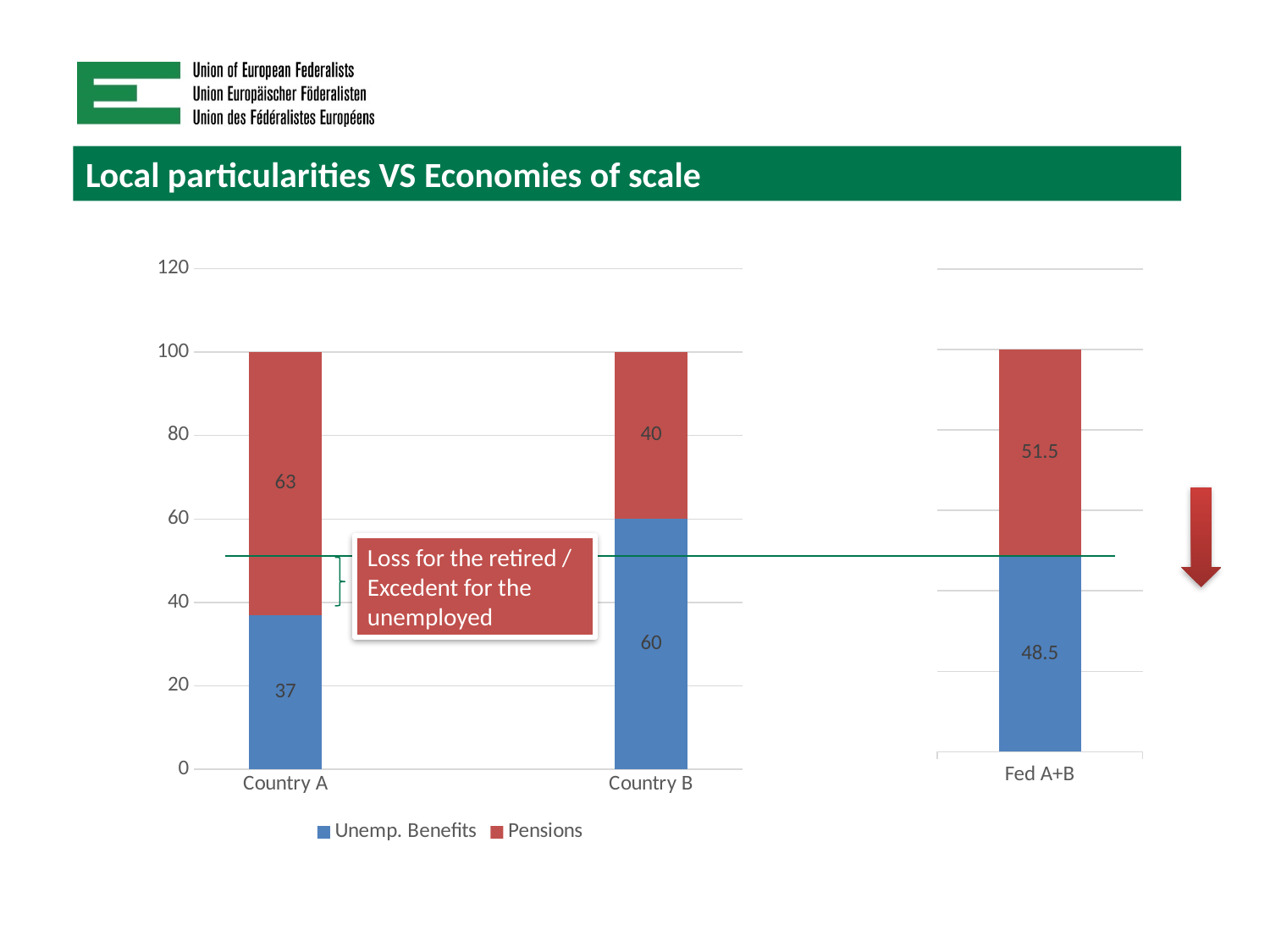
In the right chart, what is the total of the stacked bar for Fed A+B? 100 In the left chart, what is the Pensions value for Country B? 40 In the left chart, what is the total of the stacked bar for Country A? 100 In the left chart, is the Unemp. Benefits value for Country A larger or smaller than the Pensions value for Country A? smaller In the right chart, what is the Unemp. Benefits value for Fed A+B? 48.5 In the left chart, what is the Unemp. Benefits value for Country A? 37 In the left chart, which country has the lower Pensions value? Country B What kind of chart is shown on the left? Stacked bar chart How many series does the legend list? 2 In the left chart, what is the difference between the Pensions values of Country A and Country B? 23 In the left chart, which country has the higher Unemp. Benefits value? Country B In the right chart, what is the Pensions value for Fed A+B? 51.5